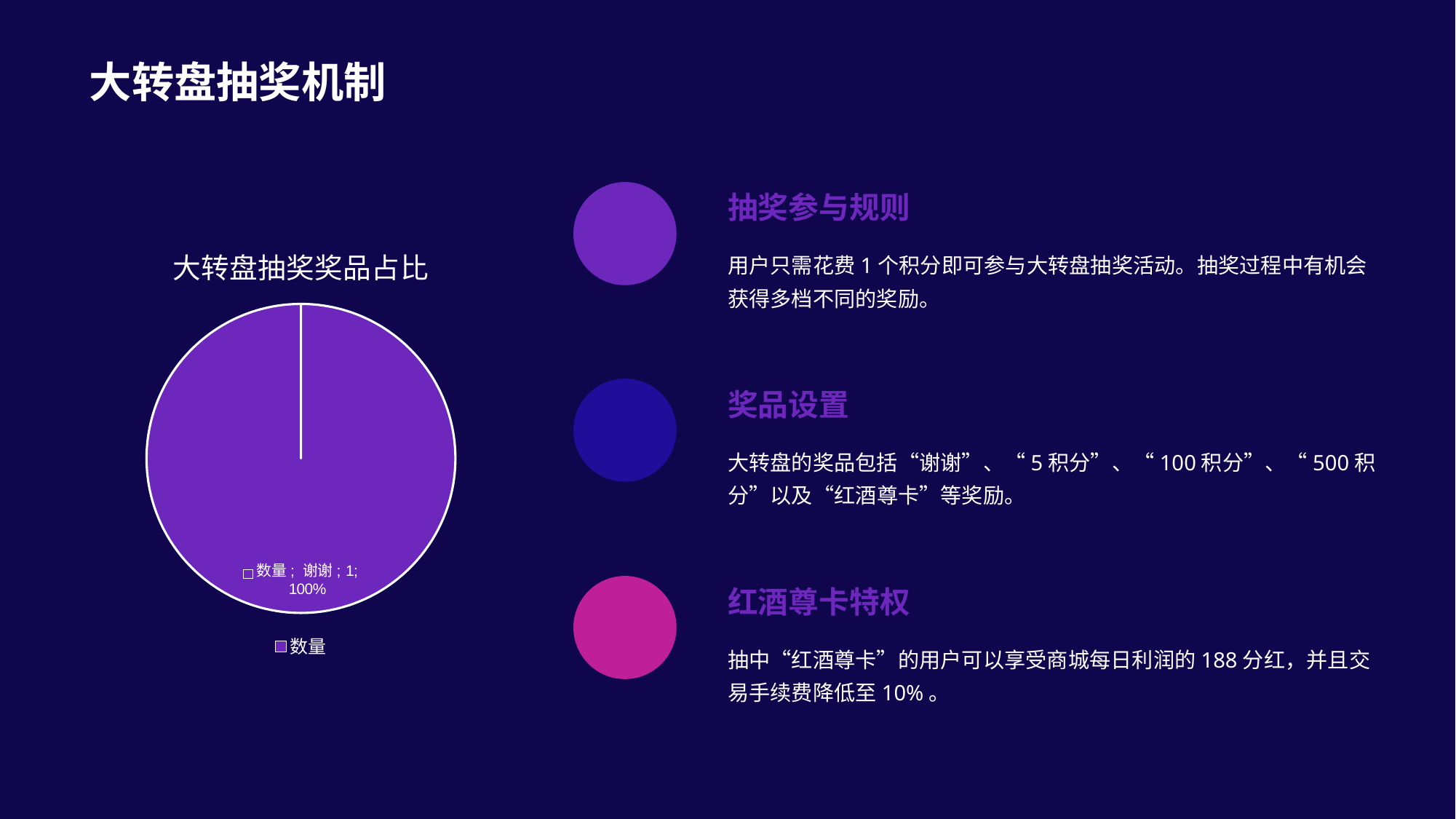
How many series does the legend list? 1 What kind of chart is shown on the slide? pie chart What is the title of the chart? 大转盘抽奖奖品占比 What share of the pie does the 谢谢 slice represent? 100% How many slices does the pie chart have? 1 What is the value labelled for the 谢谢 slice? 1 Which category is the largest slice of the pie? 谢谢 What is the name of the series shown in the legend? 数量